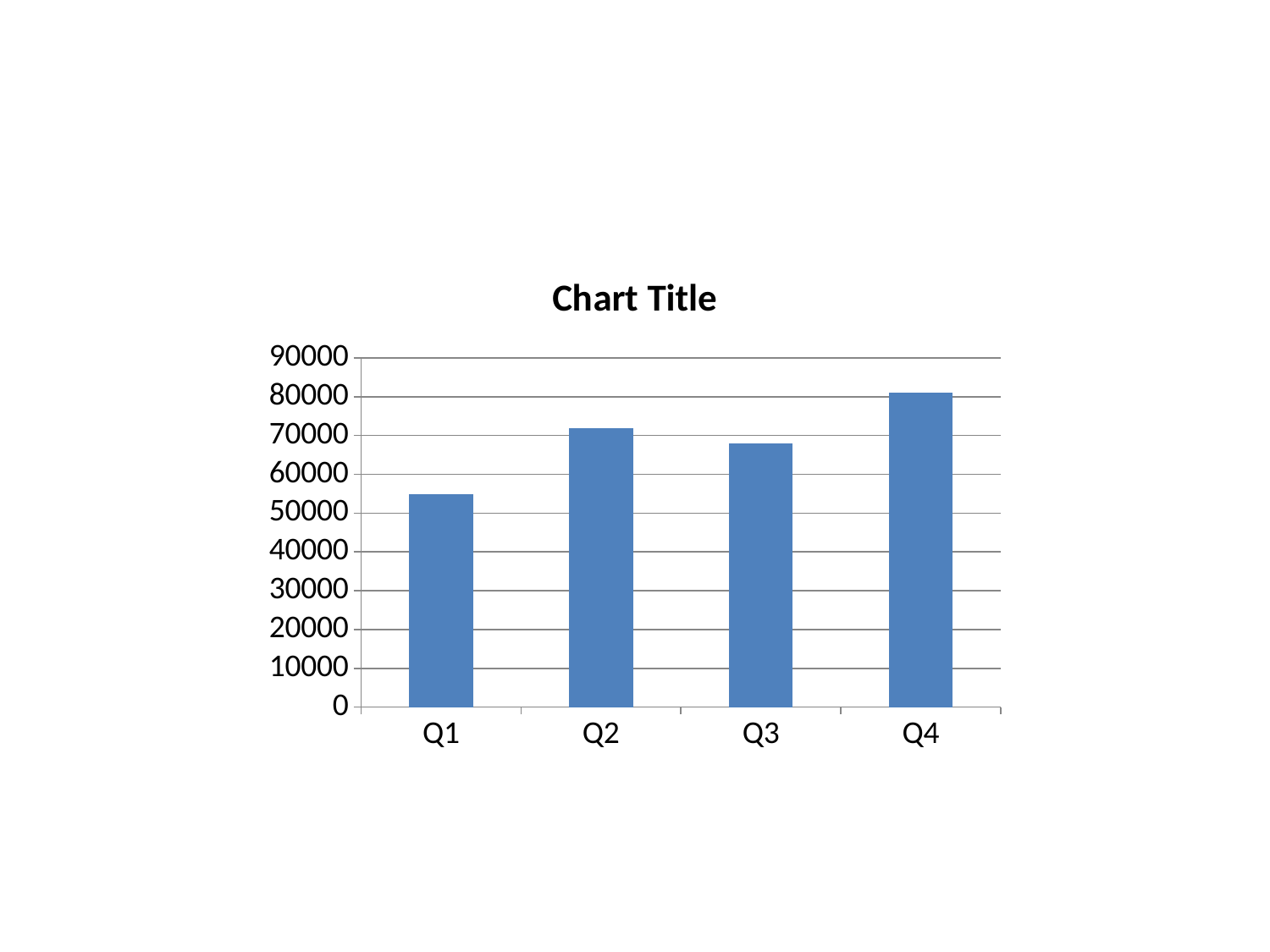
Which is larger, the value for Q1 or the value for Q4? Q4 Is the value for Q1 greater or less than 60000? less How many categories are shown on the x axis? 4 Which quarter has the highest bar? Q4 Does the value rise or fall from Q2 to Q3? fall Which quarter has the lowest bar? Q1 Is the value for Q2 greater or less than 70000? greater Is the value for Q3 greater or less than 70000? less Which is larger, the value for Q2 or the value for Q3? Q2 What is the title of the chart? Chart Title What kind of chart is shown on the slide? bar chart